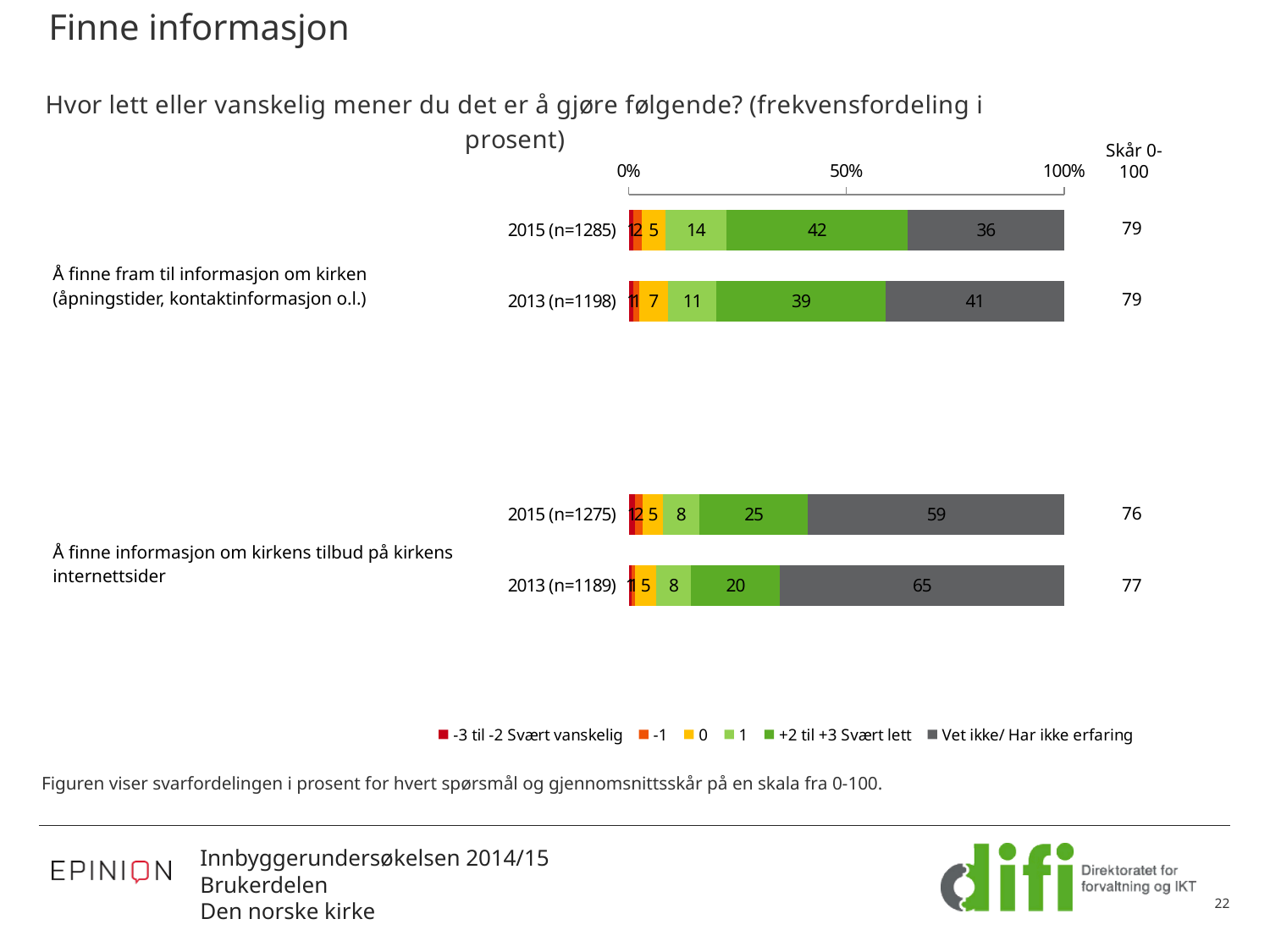
What is the value for the "0" series in the 2013 (n=1198) bar? 7 Which has the larger "Vet ikke/ Har ikke erfaring" value: 2015 (n=1275) or 2013 (n=1189)? 2013 (n=1189) What is the value for "+2 til +3 Svært lett" in the 2013 (n=1198) bar? 39 How many series does the legend list? 6 What is the value for the "1" series in the 2015 (n=1275) bar? 8 What is the value for "Vet ikke/ Har ikke erfaring" in the 2015 (n=1285) bar? 36 What is the "Skår 0-100" value shown for the 2015 (n=1275) bar? 76 What is the value for "Vet ikke/ Har ikke erfaring" in the 2013 (n=1189) bar? 65 How many bars are plotted in the chart? 4 What kind of chart is shown on the slide? Stacked bar chart Which bar has the highest value for "Vet ikke/ Har ikke erfaring"? 2013 (n=1189) What is the difference between the "+2 til +3 Svært lett" values for 2015 (n=1285) and 2013 (n=1198)? 3